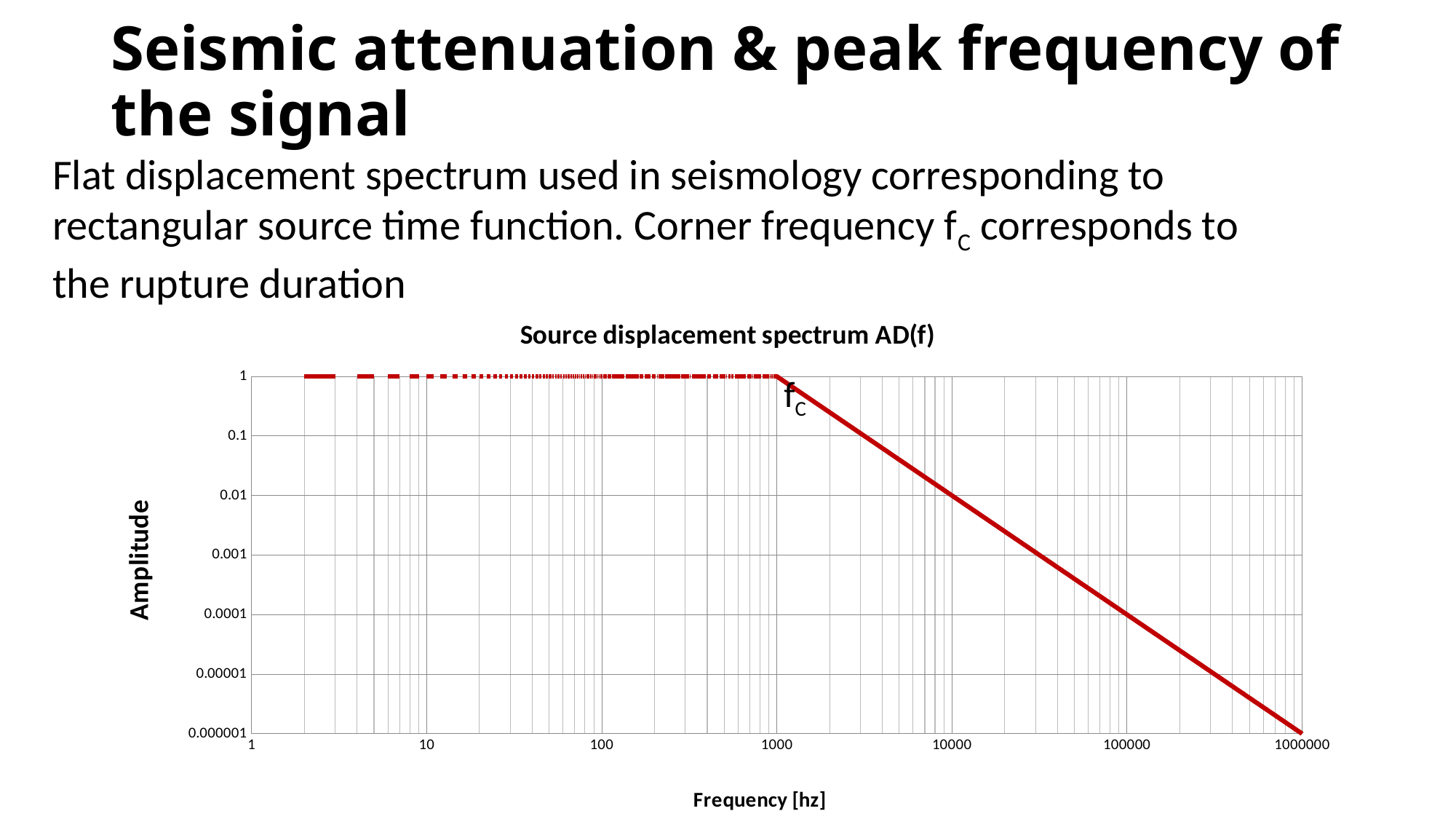
Is the amplitude at 10 Hz greater or less than 0.1? greater Is the amplitude at 10000 Hz greater or less than 0.1? less What is the lowest amplitude value reached by the plotted line? 0.000001 What is the title of the chart? Source displacement spectrum AD(f) Is the amplitude at 100000 Hz greater or less than 0.001? less What is the amplitude of the spectrum at a frequency of 1000000 Hz? 0.000001 What is the label of the vertical axis of the chart? Amplitude What is the highest amplitude value reached by the plotted line? 1 What is the amplitude of the spectrum at a frequency of 100 Hz? 1 What kind of chart is shown on the slide? line chart Does the amplitude rise, fall, or stay flat as frequency increases beyond the corner frequency fc? fall Is the amplitude at 100 Hz larger or smaller than the amplitude at 10000 Hz? larger